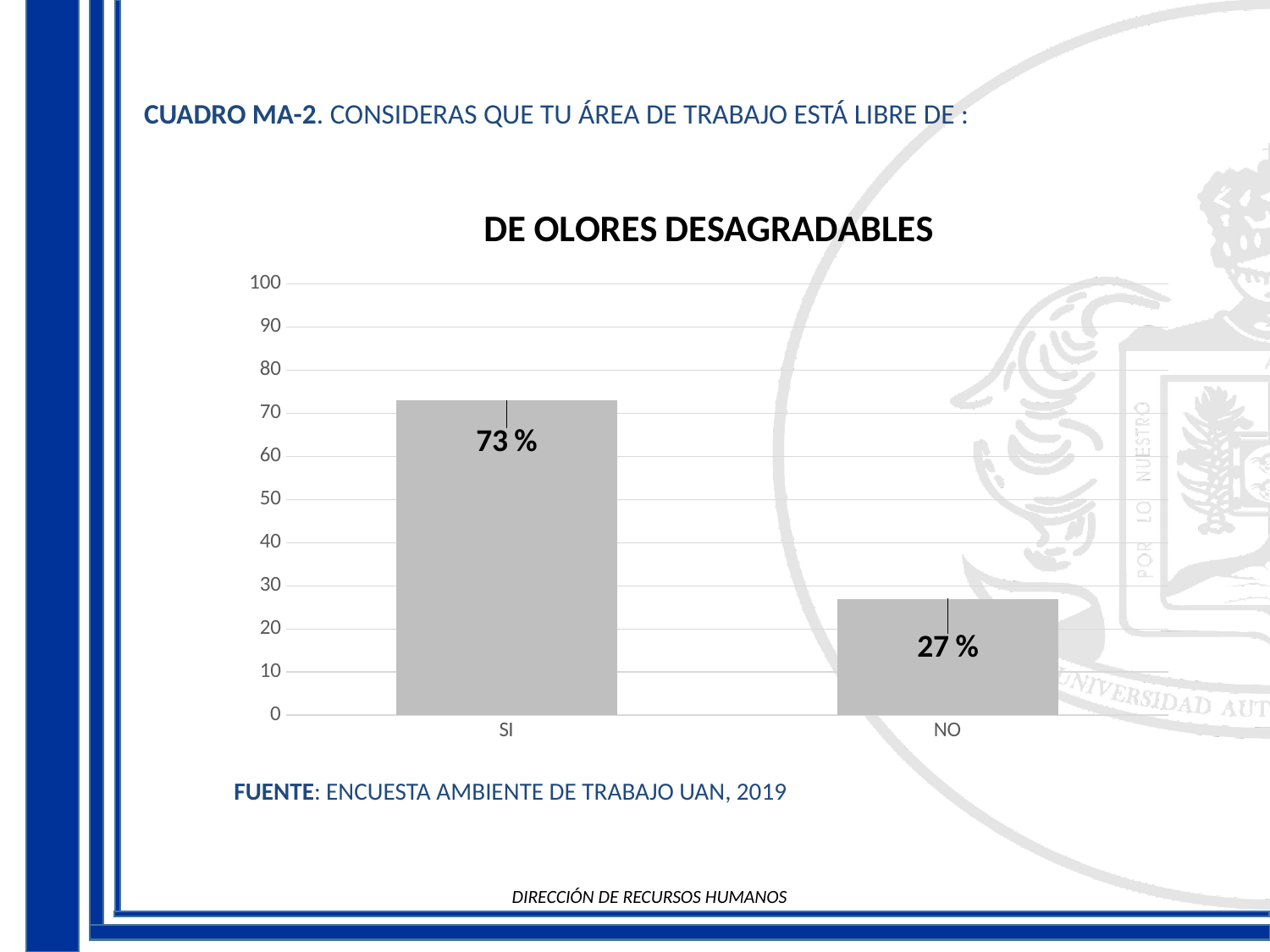
Which category has the lowest value? NO What is the value for NO? 27 % How many categories are shown on the x axis? 2 Which is larger, the value for SI or the value for NO? SI What is the value for SI? 73 % What kind of chart is shown? bar chart Which category has the highest value? SI What is the total of the two values shown? 100 % What is the title of the chart? DE OLORES DESAGRADABLES Is the value for SI greater or less than 70? greater What is the difference between the values for SI and NO? 46 % Is the value for NO greater or less than 30? less